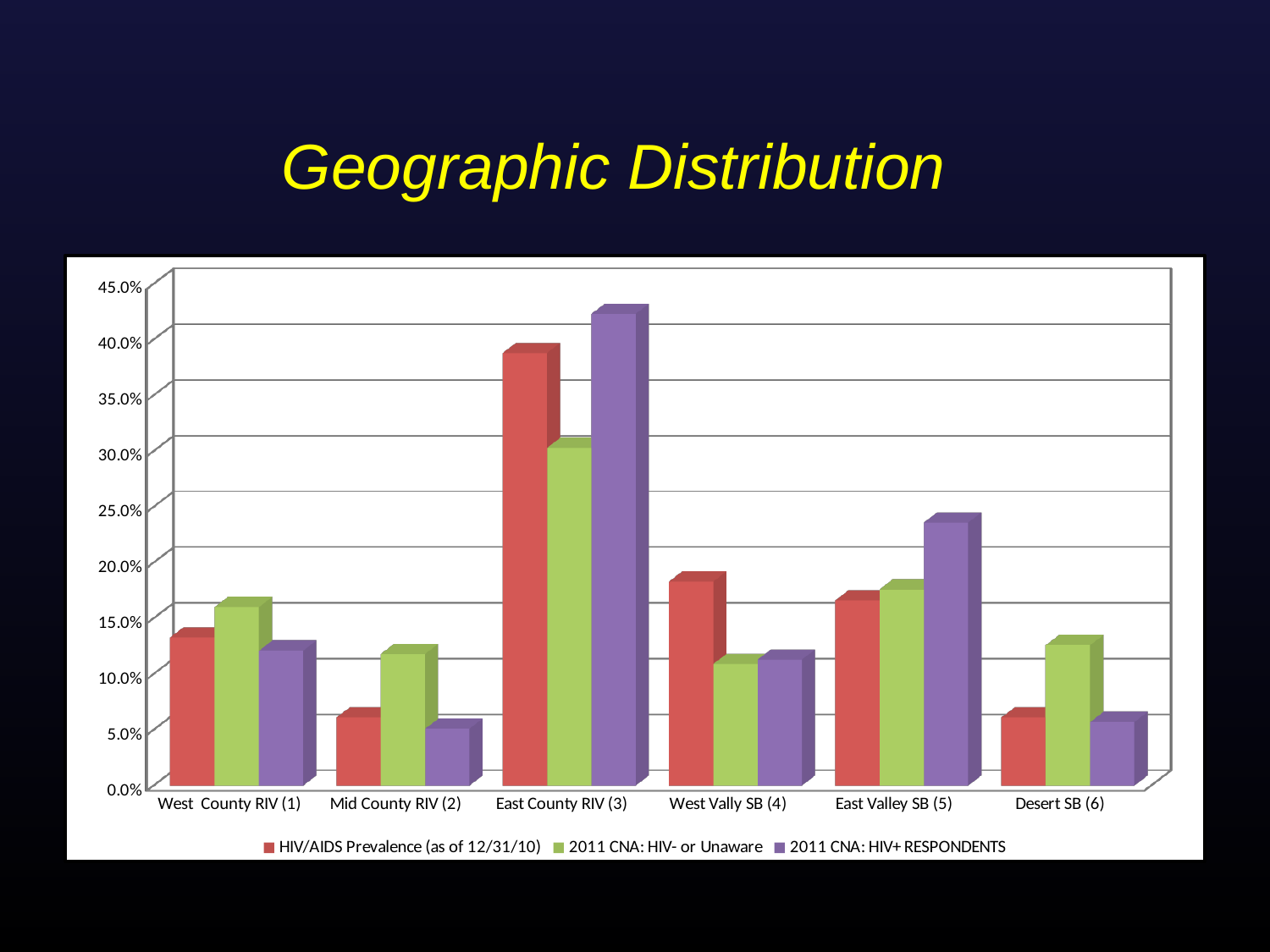
Is the value for 2011 CNA: HIV- or Unaware in Desert SB (6) greater or less than 10.0%? greater Is the value for 2011 CNA: HIV+ RESPONDENTS in East Valley SB (5) greater or less than 20.0%? greater What kind of chart is shown on the slide? Bar chart Which category has the highest value for 2011 CNA: HIV+ RESPONDENTS? East County RIV (3) In Mid County RIV (2), which is larger: 2011 CNA: HIV- or Unaware or HIV/AIDS Prevalence (as of 12/31/10)? 2011 CNA: HIV- or Unaware How many geographic categories are shown on the x axis? 6 What is the title of the slide containing the chart? Geographic Distribution Is the value for HIV/AIDS Prevalence (as of 12/31/10) in West Vally SB (4) greater or less than 15.0%? greater In East County RIV (3), which is larger: 2011 CNA: HIV+ RESPONDENTS or HIV/AIDS Prevalence (as of 12/31/10)? 2011 CNA: HIV+ RESPONDENTS How many series does the legend list? 3 Which category has the highest value for HIV/AIDS Prevalence (as of 12/31/10)? East County RIV (3)